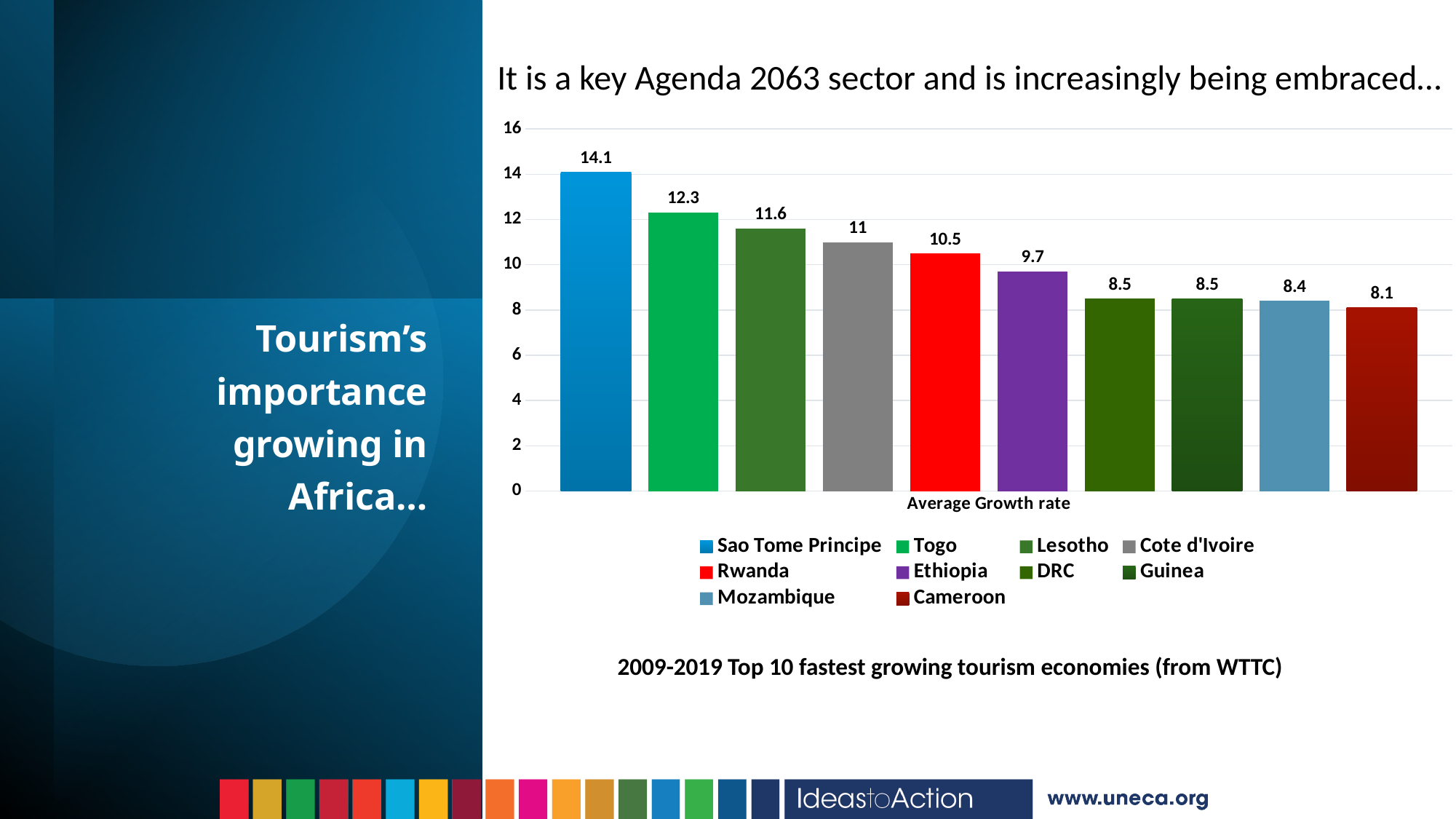
What kind of chart is shown on the slide? bar chart How many countries are shown in the chart? 10 Which has a higher average growth rate, Cote d'Ivoire or Mozambique? Cote d'Ivoire What is the average growth rate for Ethiopia? 9.7 What is the average growth rate for Rwanda? 10.5 Is the value for Guinea greater or less than 10? less Which country has the highest average growth rate? Sao Tome Principe How many entries does the legend list? 10 What is the average growth rate for Sao Tome Principe? 14.1 Which country has the lowest average growth rate? Cameroon What is the caption below the chart? 2009-2019 Top 10 fastest growing tourism economies (from WTTC) What is the difference between the average growth rates of Togo and Lesotho? 0.7